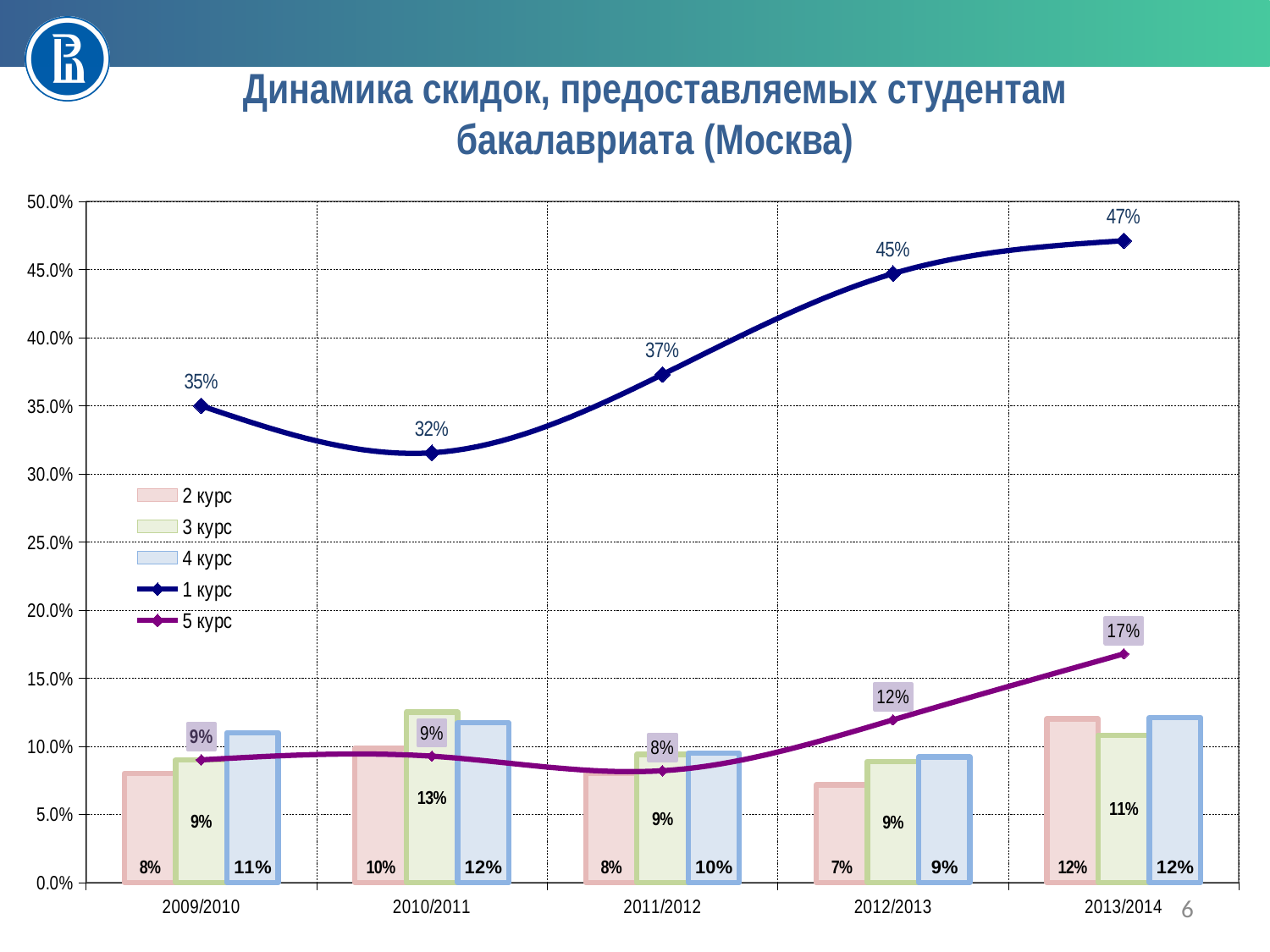
In which academic year is the value for 1 курс the lowest? 2010/2011 Does the value for 1 курс rise or fall from 2011/2012 to 2013/2014? Rise What is the value for 1 курс in 2012/2013? 45% What is the value for 2 курс in 2010/2011? 10% What is the value for 3 курс in 2011/2012? 9% How many series does the legend list? 5 In which academic year is the value for 1 курс the highest? 2013/2014 What kind of chart is this? Combined bar and line chart What is the value for 5 курс in 2013/2014? 17% How many academic years are shown on the x axis? 5 By how much did the value for 1 курс increase from 2009/2010 to 2013/2014? 12% In 2009/2010, which is larger: the value for 4 курс or the value for 2 курс? 4 курс